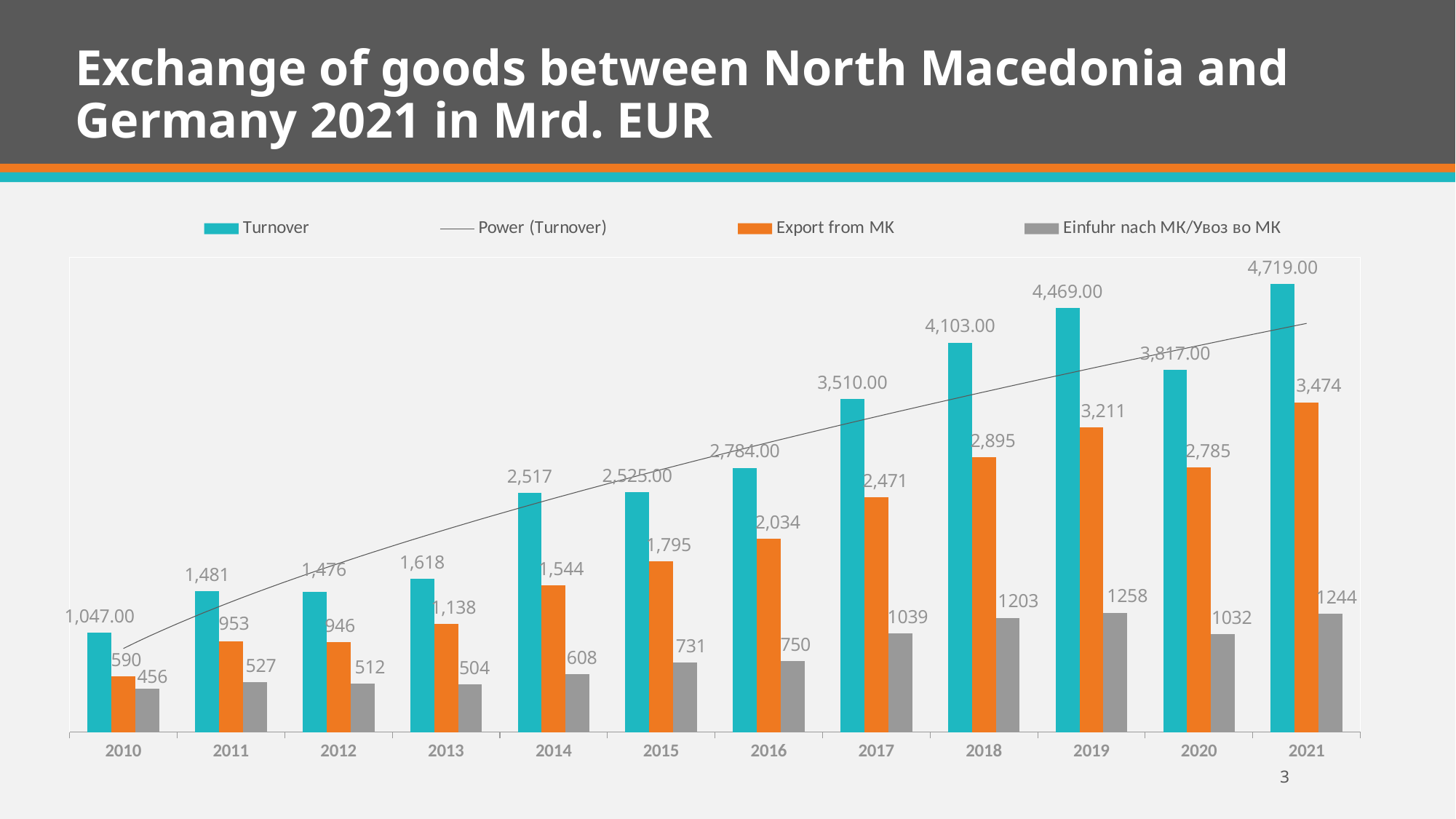
Which year has the lowest Einfuhr nach MK/Увоз во МК value? 2010 What is the Einfuhr nach MK/Увоз во МК value for 2019? 1258 What is the difference between the Turnover and the Export from MK in 2021? 1,245 Does the Turnover generally rise or fall from 2010 to 2021? Rise How many years are shown on the x axis? 12 What is the Turnover value for 2017? 3,510.00 By how much did Export from MK fall from 2019 to 2020? 426 Which year has the highest Turnover? 2021 What kind of chart is shown on the slide? Bar chart with a trend line Which is larger, the Export from MK in 2018 or in 2020? 2018 How many series does the legend list? 4 What is the Export from MK value for 2014? 1,544